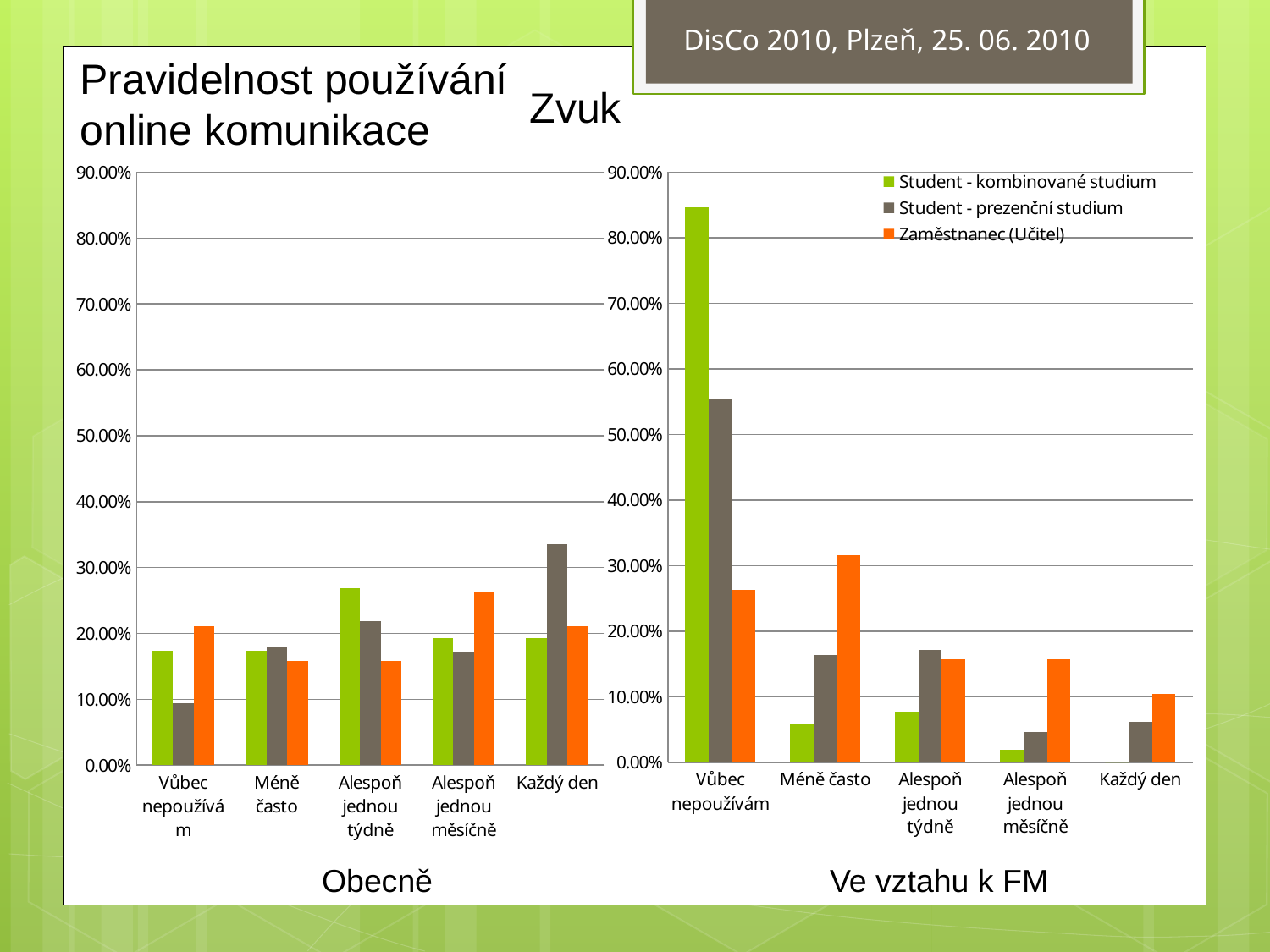
In the right chart (Ve vztahu k FM), which category has the highest value for Student - kombinované studium? Vůbec nepoužívám What kind of chart is the left chart (Obecně)? bar chart How many series does the legend of the right chart (Ve vztahu k FM) list? 3 In the right chart (Ve vztahu k FM), which is larger at Méně často: Zaměstnanec (Učitel) or Student - prezenční studium? Zaměstnanec (Učitel) In the right chart (Ve vztahu k FM), what colour represents Zaměstnanec (Učitel) in the legend? orange In the left chart (Obecně), which category has the highest value for Student - kombinované studium? Alespoň jednou týdně In the left chart (Obecně), which category has the highest value for Student - prezenční studium? Každý den In the left chart (Obecně), which category has the lowest value for Student - prezenční studium? Vůbec nepoužívám In the right chart (Ve vztahu k FM), is the value for Student - prezenční studium at Vůbec nepoužívám greater or less than 50.00%? greater How many categories are shown on the x axis of the left chart (Obecně)? 5 In the left chart (Obecně), is the value for Student - prezenční studium at Každý den greater or less than 30.00%? greater In the right chart (Ve vztahu k FM), is the value for Student - kombinované studium at Vůbec nepoužívám greater or less than 80.00%? greater